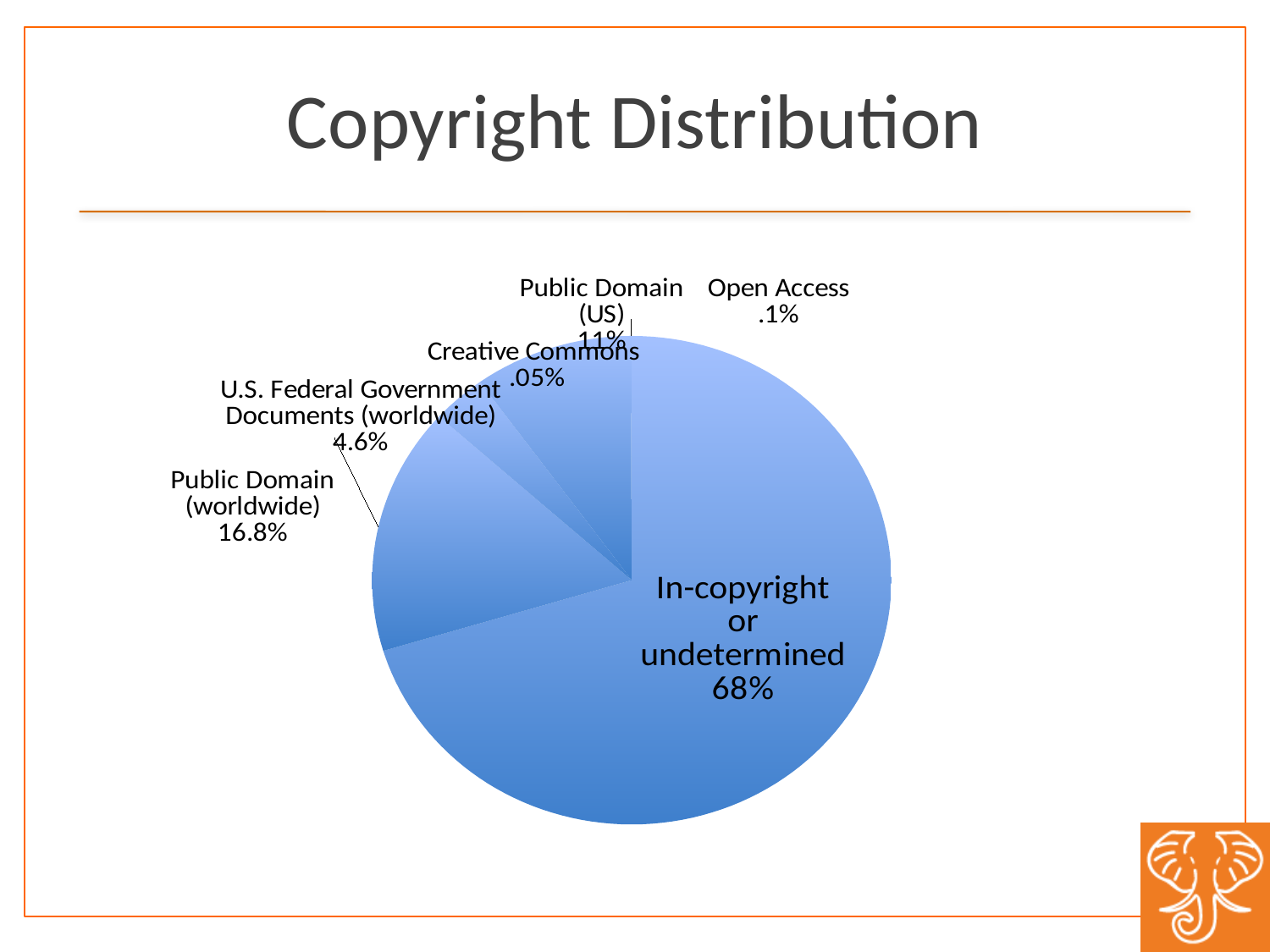
What is the title of the chart on the slide? Copyright Distribution Which is larger, Public Domain (worldwide) or U.S. Federal Government Documents (worldwide)? Public Domain (worldwide) What is the value for Creative Commons? .05% What is the difference in percentage points between In-copyright or undetermined and Public Domain (worldwide)? 51.2 Which category has the smallest slice of the pie? Creative Commons What kind of chart is shown on the slide? pie chart What is the value for Public Domain (worldwide)? 16.8% Which category has the largest slice of the pie? In-copyright or undetermined How many categories are shown in the pie chart? 6 What is the value for Open Access? .1% What share of the pie is In-copyright or undetermined? 68% What is the value for U.S. Federal Government Documents (worldwide)? 4.6%